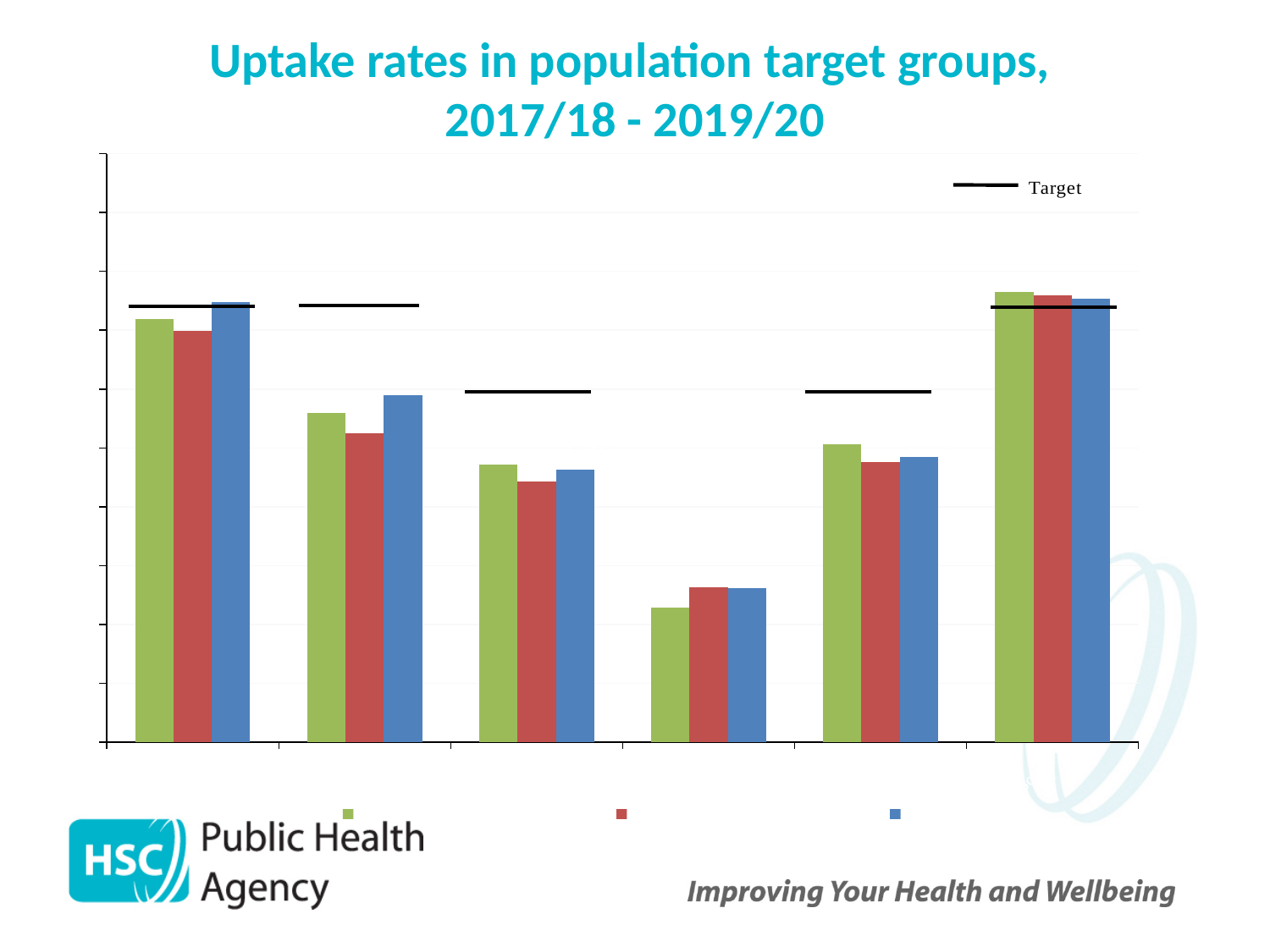
How many groups of bars are plotted along the x axis? 6 In the rightmost group, are the bars above or below the target line? above Which group of bars, counting from the left, has the tallest bars? the sixth (rightmost) group How many groups have a target line drawn above them? 5 How many coloured bars are there in each group? 3 What is the title of the chart? Uptake rates in population target groups, 2017/18 - 2019/20 What does the black horizontal line in the legend represent? Target What kind of chart is shown on the slide? bar chart In the fourth group from the left, is the green bar taller or shorter than the red bar? shorter In the leftmost group, is the blue bar taller or shorter than the green bar? taller Which group of bars, counting from the left, has the shortest bars? the fourth group